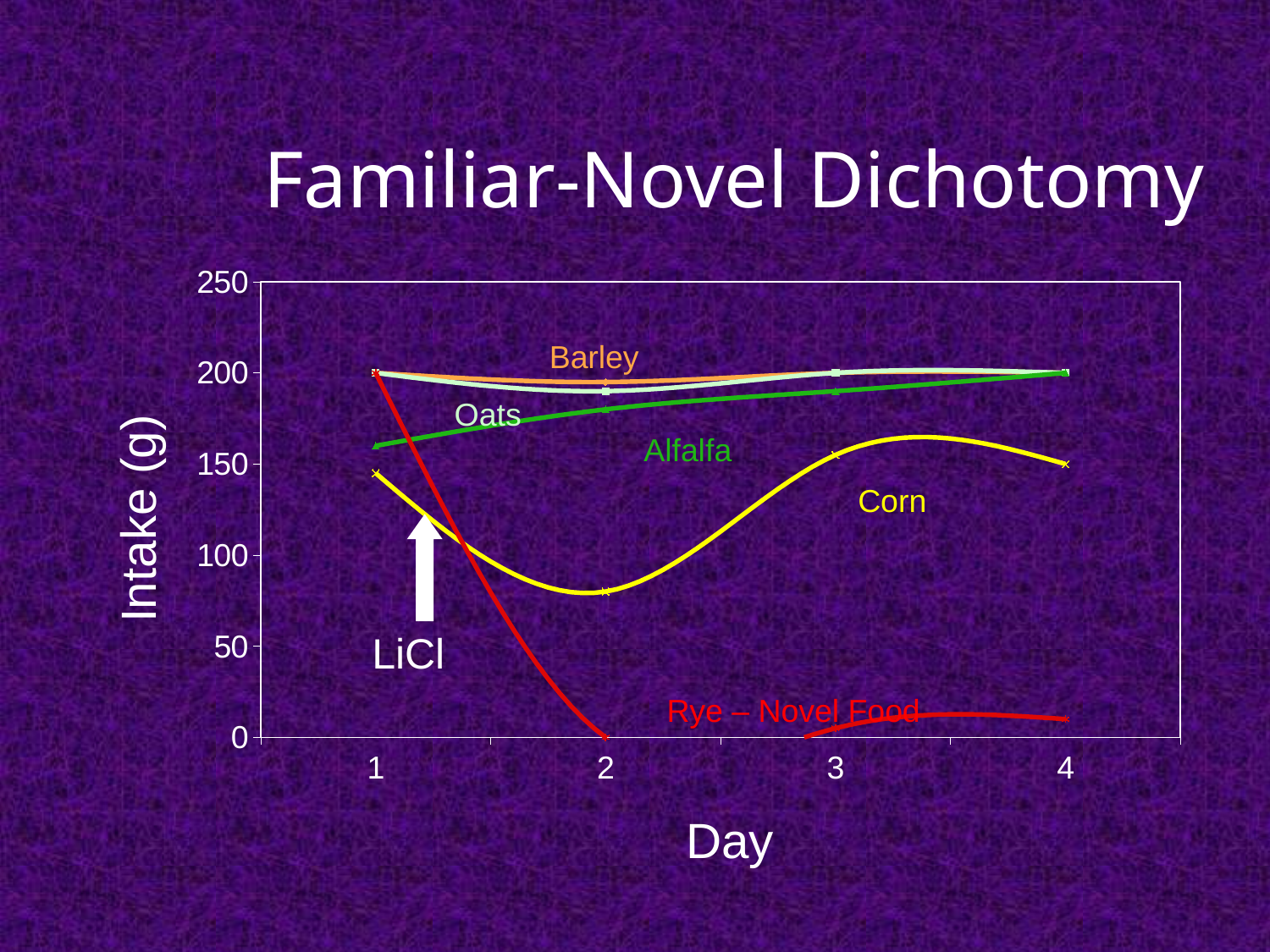
What kind of chart is shown on the slide? line chart What is the title of the chart on the slide? Familiar-Novel Dichotomy Which food has the lowest intake on day 4? Rye – Novel Food On day 2, which has the larger intake, Corn or Alfalfa? Alfalfa What is the label of the y axis? Intake (g) Is the intake of Corn on day 2 greater or less than 100? less How many food series are labelled on the chart? 5 Which food has the lowest intake on day 2? Rye – Novel Food Does the intake of Rye – Novel Food rise or fall from day 1 to day 2? fall Is the intake of Alfalfa on day 1 greater or less than 150? greater Does the intake of Alfalfa rise or fall from day 1 to day 4? rise How many days are shown on the x axis? 4